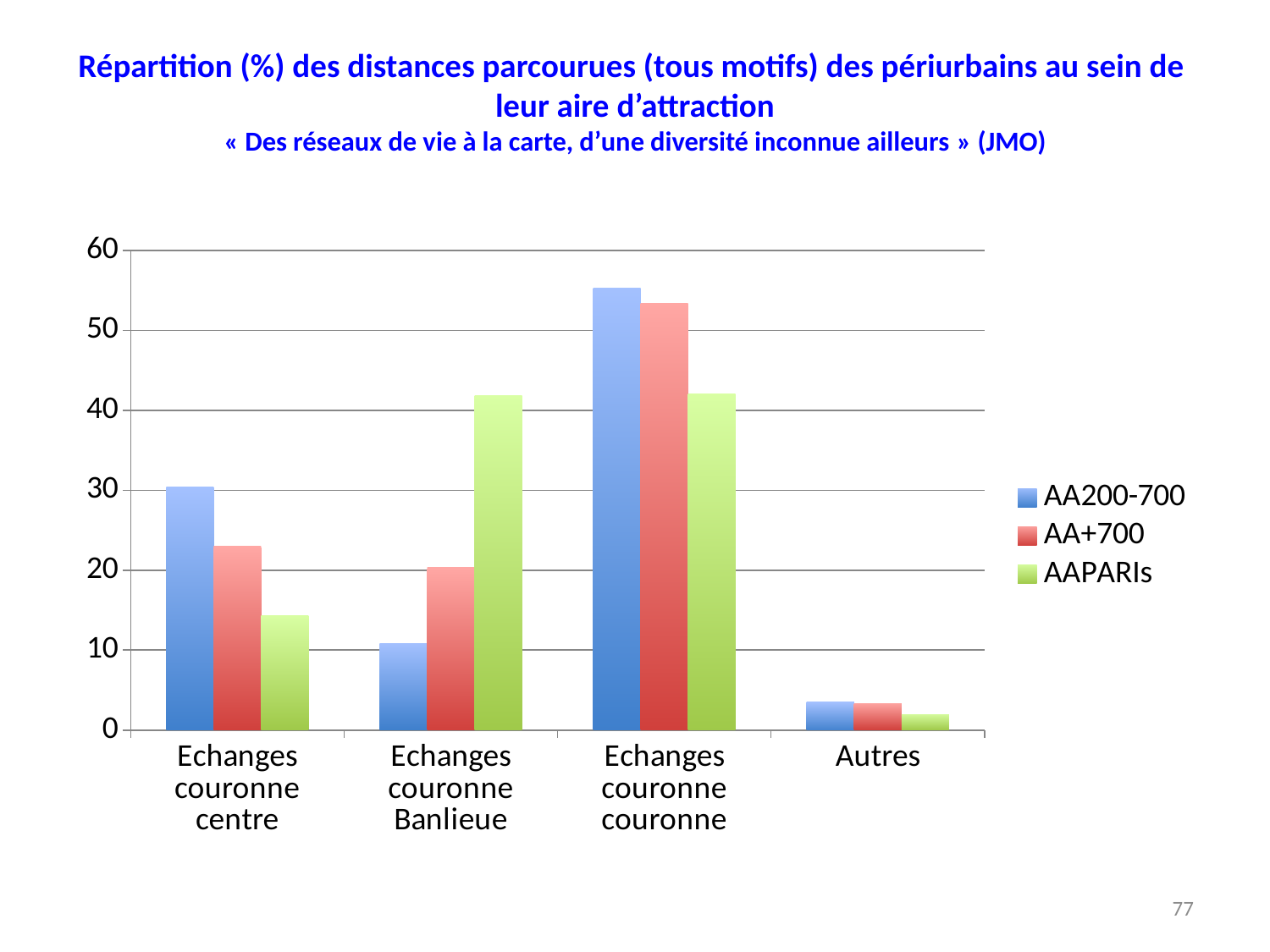
What kind of chart is shown on the slide? bar chart For Echanges couronne centre, which is larger: AA200-700 or AA+700? AA200-700 Which category has the lowest AAPARIs bar? Autres Which category has the highest AA200-700 bar? Echanges couronne couronne Which series has the highest bar for Echanges couronne centre? AA200-700 How many categories are shown on the x axis? 4 How many series does the legend list? 3 Is the AA+700 value for Echanges couronne couronne greater or less than 50? greater Is the AAPARIs value for Echanges couronne Banlieue greater or less than 30? greater What colour represents the AAPARIs series in the legend? green For Echanges couronne Banlieue, which is larger: AAPARIs or AA200-700? AAPARIs Is the AA200-700 value for Echanges couronne Banlieue greater or less than 20? less